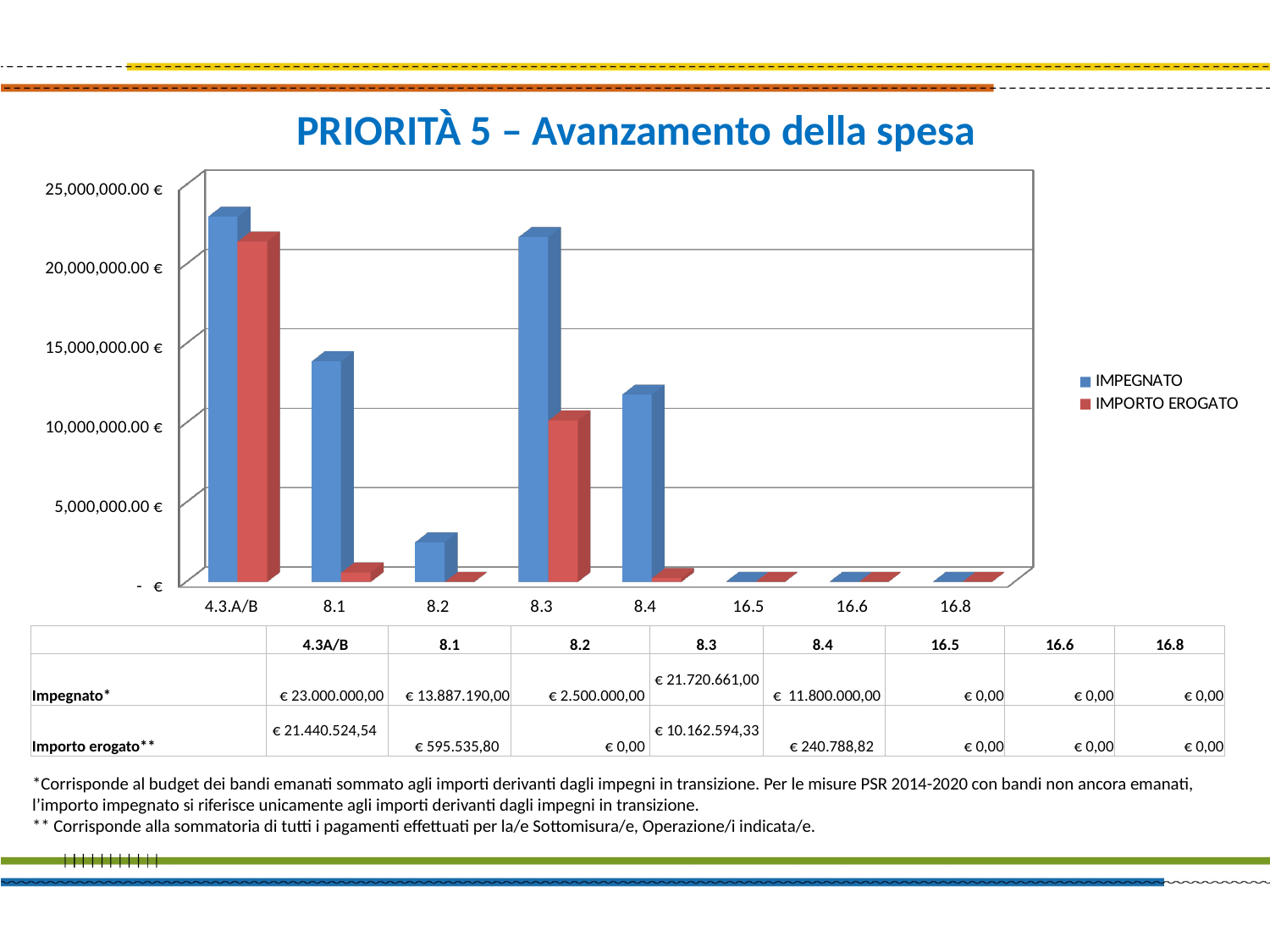
What is the IMPEGNATO value for category 8.3? € 21.720.661,00 What is the difference between IMPEGNATO and IMPORTO EROGATO for category 8.3? € 11.558.066,67 Which category has the highest IMPORTO EROGATO value? 4.3A/B What kind of chart is shown on the slide? bar chart Which is larger, the IMPEGNATO value for 8.3 or for 8.4? 8.3 What is the difference between the IMPEGNATO values for 8.1 and 8.4? € 2.087.190,00 What is the IMPORTO EROGATO value for category 8.4? € 240.788,82 Is the IMPEGNATO value for 8.1 greater or less than 10,000,000.00 €? greater What is the IMPORTO EROGATO value for category 4.3A/B? € 21.440.524,54 How many series does the legend list? 2 How many categories are shown on the x axis of the chart? 8 Which category has the highest IMPEGNATO value? 4.3A/B